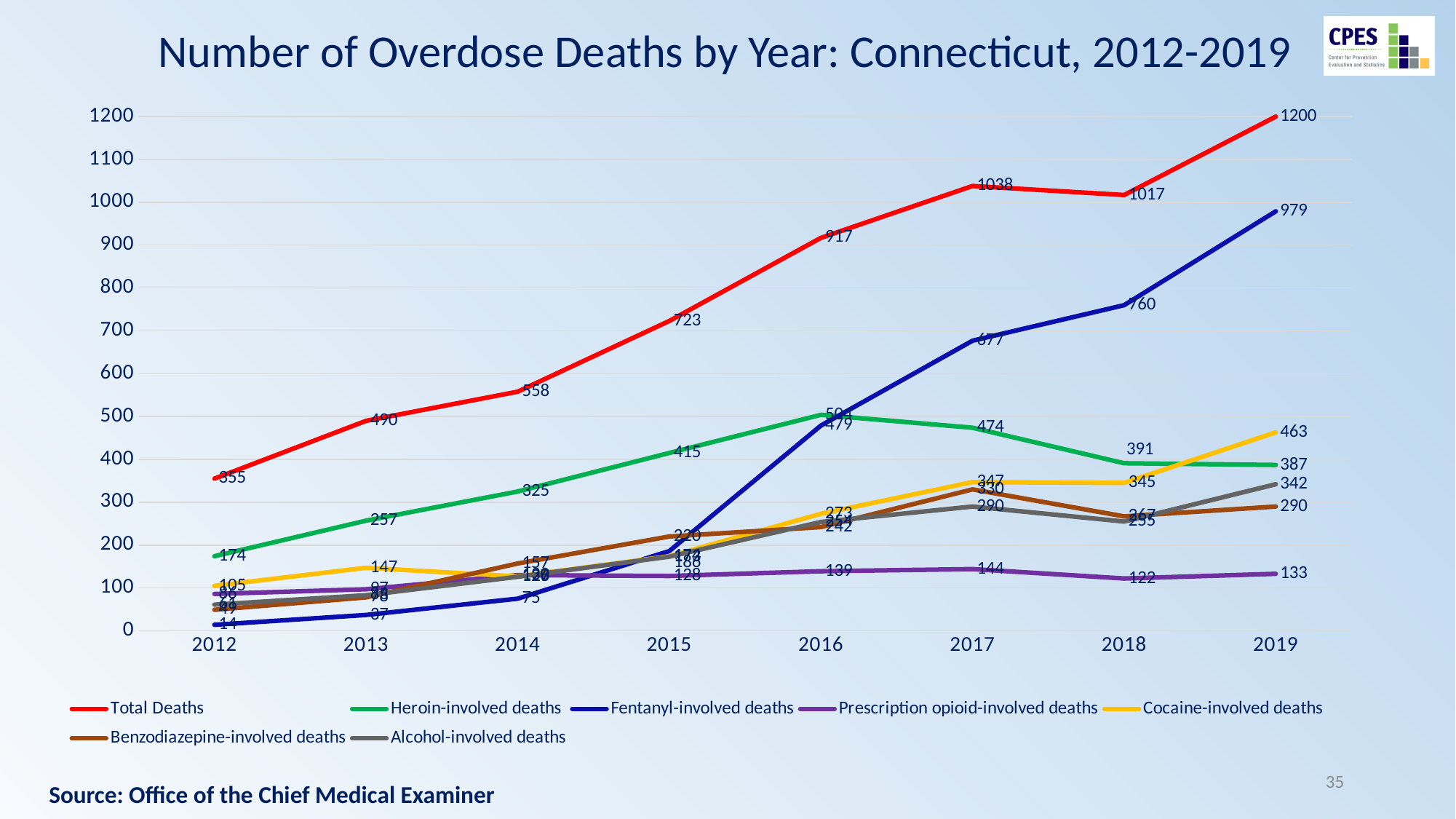
How many series does the legend list? 7 What is the value for Heroin-involved deaths in 2019? 387 What is the value for Fentanyl-involved deaths in 2019? 979 What is the difference between Total Deaths in 2019 and Total Deaths in 2018? 183 Do Fentanyl-involved deaths rise or fall from 2012 to 2019? Rise What is the value for Total Deaths in 2019? 1200 What is the value for Cocaine-involved deaths in 2019? 463 In which year were Total Deaths highest? 2019 Which is larger in 2019: Heroin-involved deaths or Fentanyl-involved deaths? Fentanyl-involved deaths How many years are plotted on the x axis? 8 In which year were Total Deaths lowest? 2012 What kind of chart is shown on the slide? Line chart